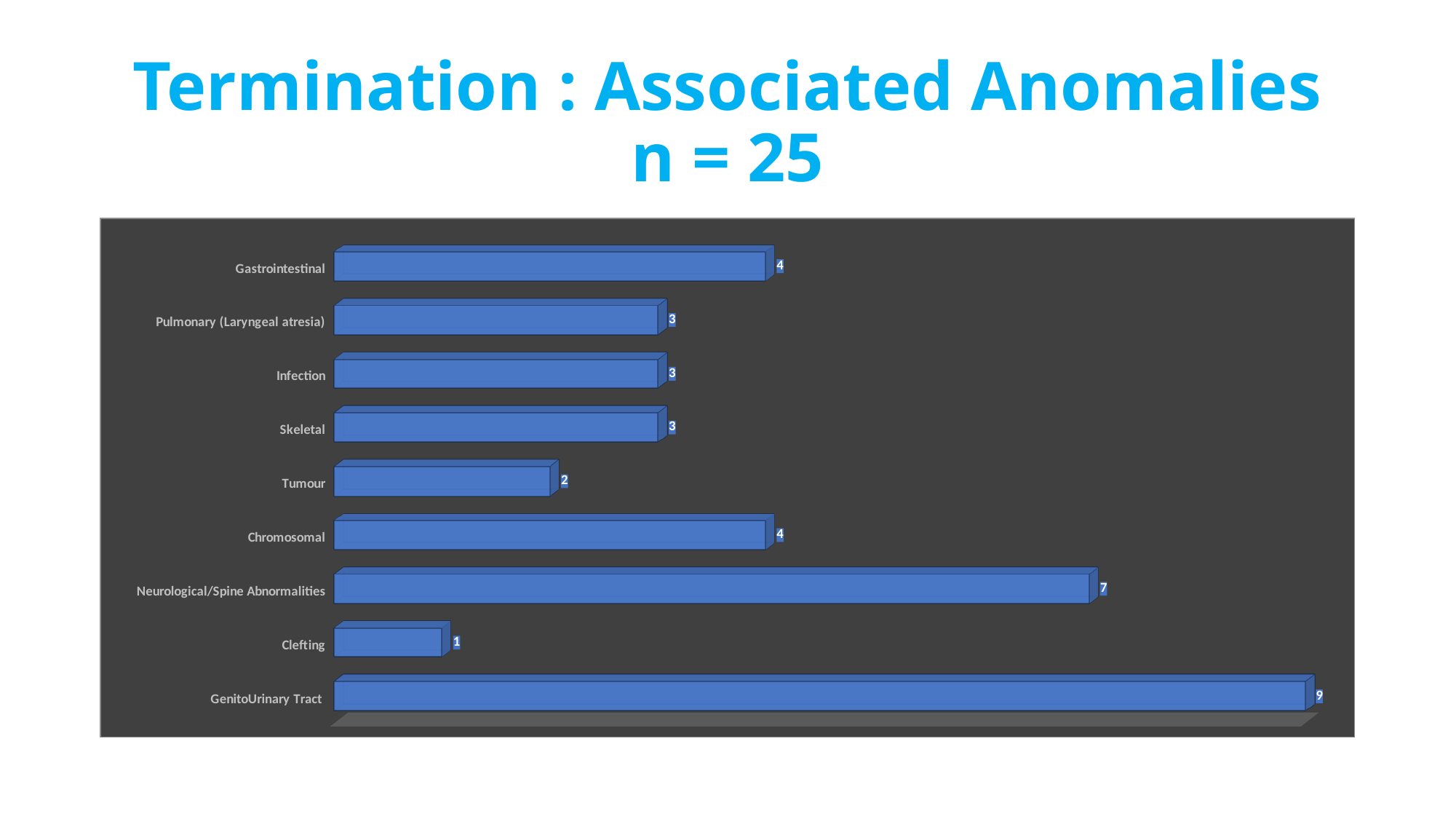
Which category has the lowest value? Clefting What is the value for Neurological/Spine Abnormalities? 7 What is the value for Clefting? 1 How many categories are shown in the chart? 9 What is the difference between the values for GenitoUrinary Tract and Neurological/Spine Abnormalities? 2 Which is larger, the value for Chromosomal or the value for Skeletal? Chromosomal What is the difference between the values for Gastrointestinal and Tumour? 2 What is the value for Pulmonary (Laryngeal atresia)? 3 What is the title of the slide? Termination : Associated Anomalies n = 25 What is the value for GenitoUrinary Tract? 9 What kind of chart is shown on the slide? Bar chart Which category has the highest value? GenitoUrinary Tract